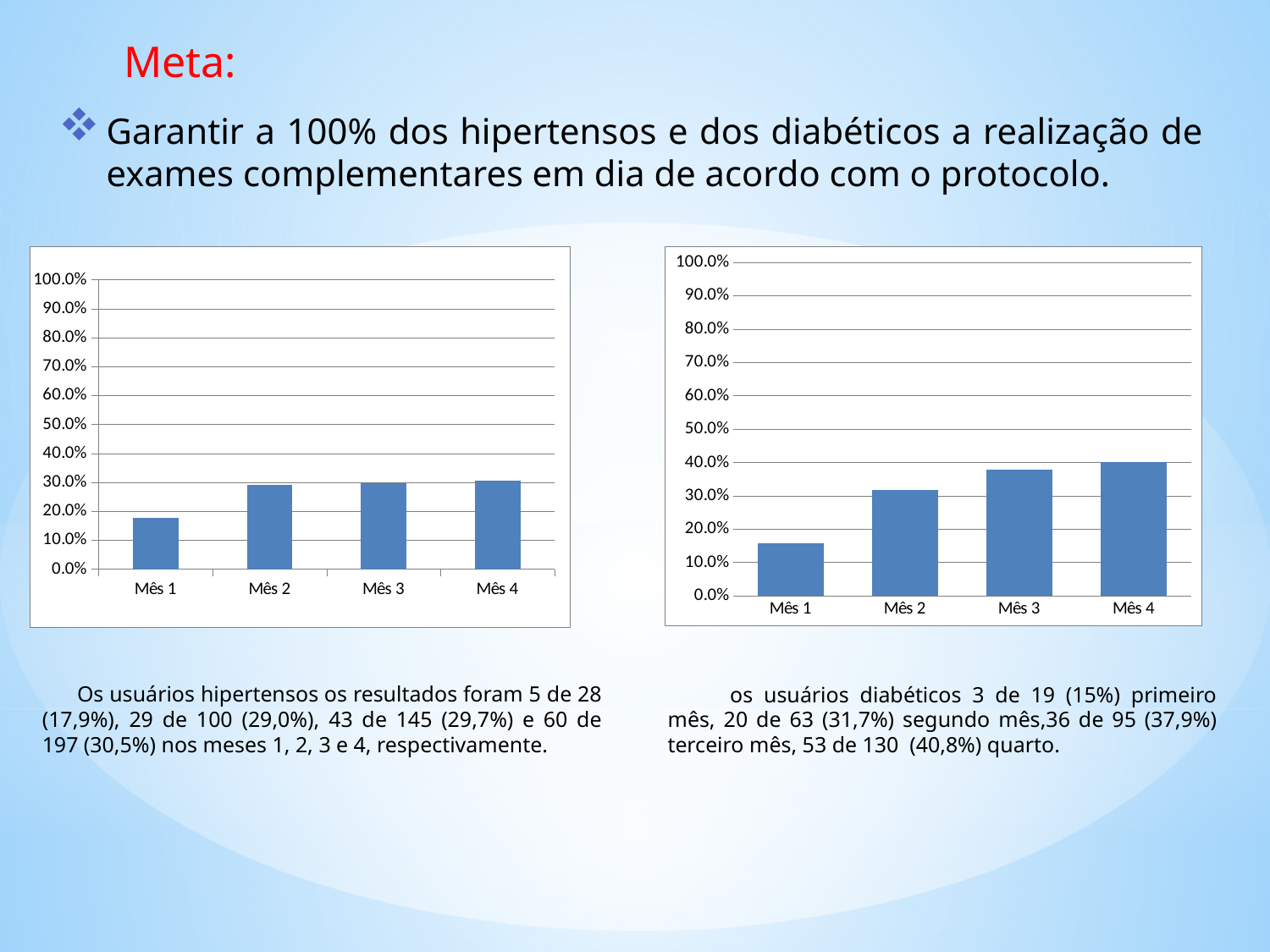
In the chart on the left of the slide, is the value for Mês 1 greater or less than 20.0%? less In the chart on the left of the slide, which month has the lowest bar? Mês 1 In the chart on the right of the slide, which month has the highest bar? Mês 4 In the chart on the right of the slide, is the value for Mês 1 greater or less than 20.0%? less In the chart on the right of the slide, is the value for Mês 2 greater or less than 30.0%? greater In the chart on the right of the slide, which month has the lowest bar? Mês 1 In the chart on the right of the slide, do the values rise or fall from Mês 1 to Mês 4? rise What kind of chart is the chart on the left of the slide? bar chart In the chart on the right of the slide, which is larger, the value for Mês 3 or the value for Mês 1? Mês 3 What is the highest tick label on the y axis of the chart on the left of the slide? 100.0% How many categories are shown on the x axis of the chart on the right of the slide? 4